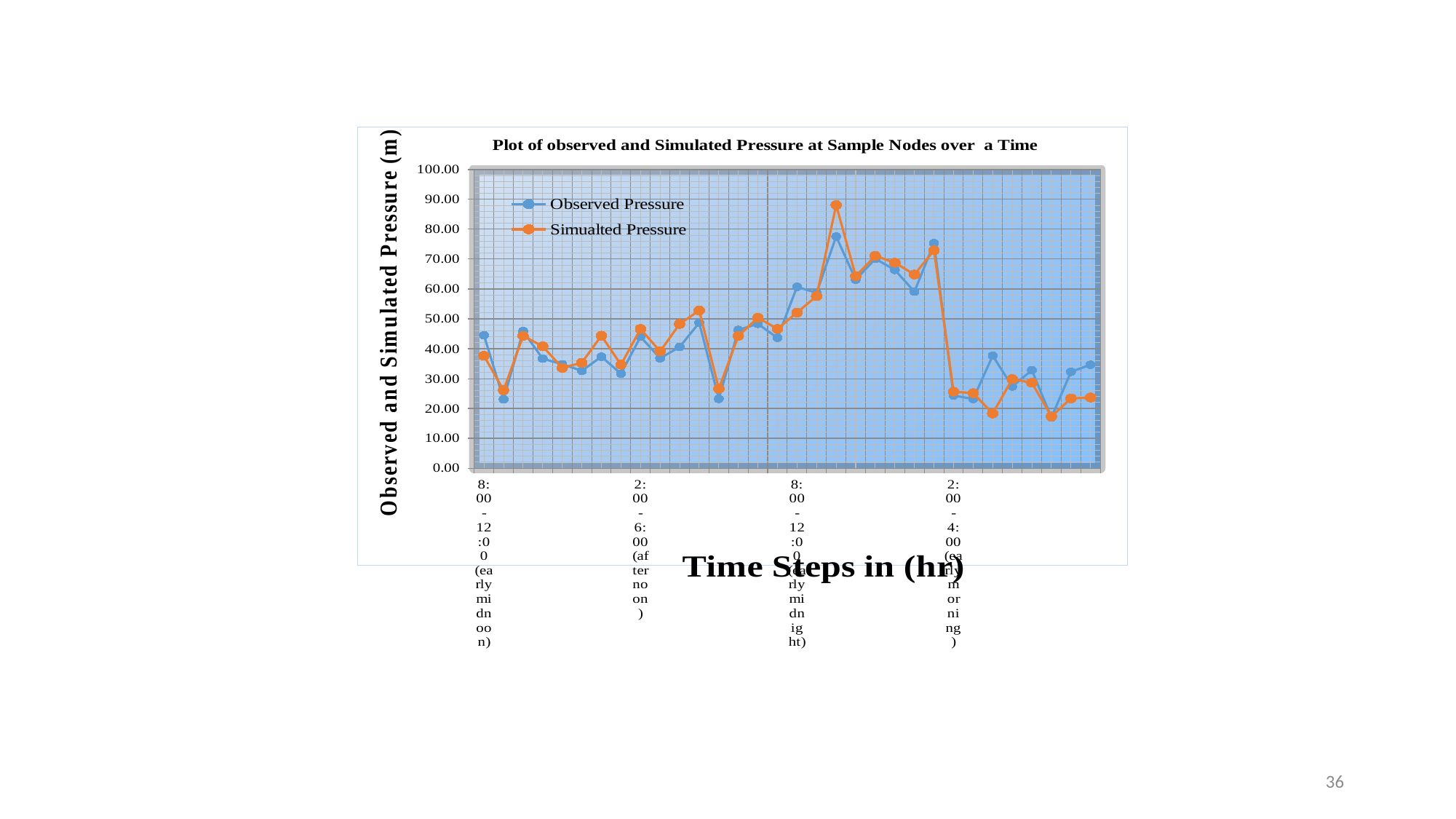
Is the lowest value of the Simulated Pressure series greater or less than 20? less Is the lowest value of the Observed Pressure series greater or less than 30? less Is the highest value reached by the Simulated Pressure series greater or less than 80? greater What is the title of the chart? Plot of observed and Simulated Pressure at Sample Nodes over a Time Which series reaches the higher peak value, Observed Pressure or Simulated Pressure? Simulated Pressure What is the label of the vertical axis? Observed and Simulated Pressure (m) What kind of chart is shown on the slide? Line chart How many series does the legend list? 2